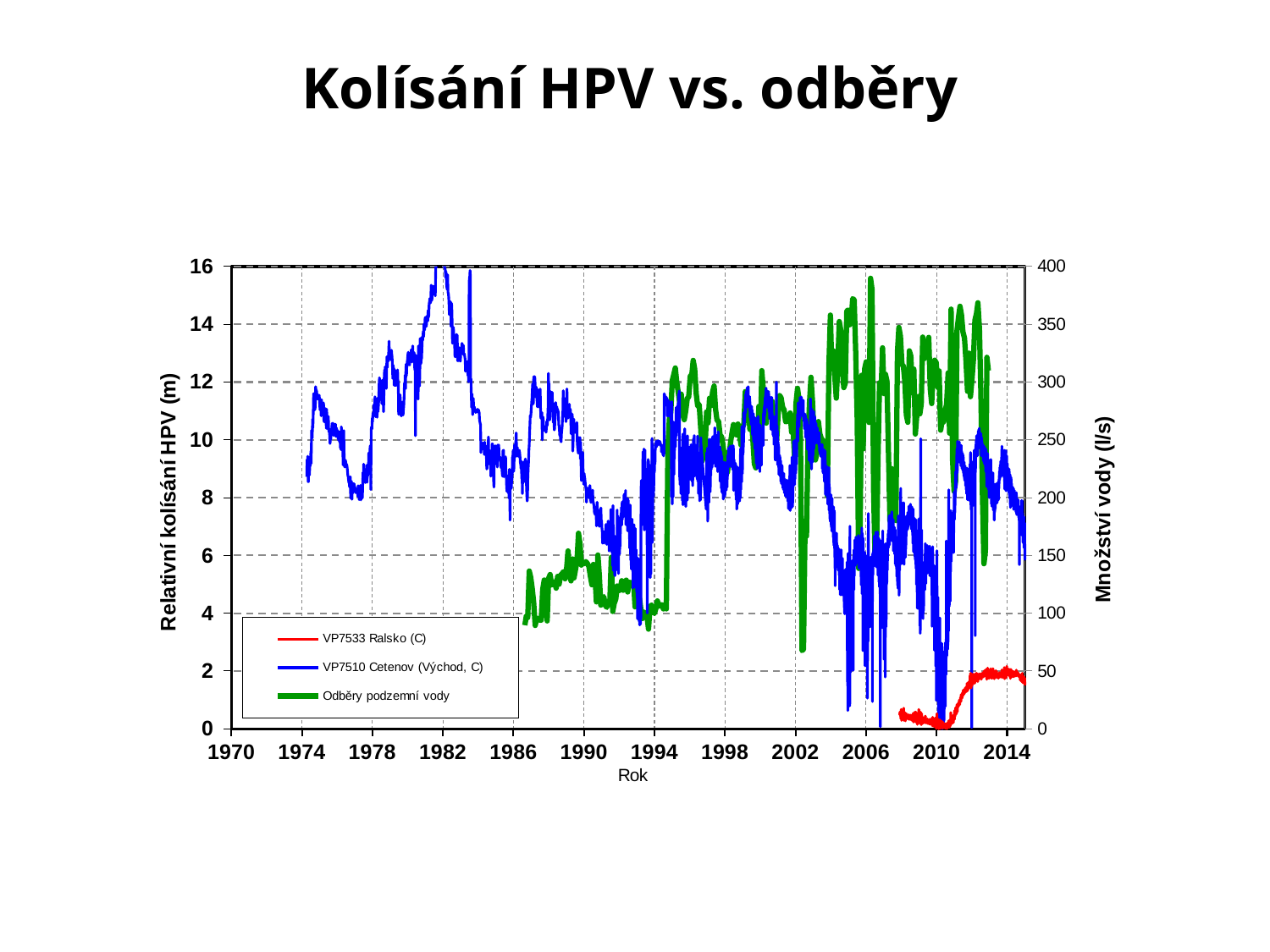
What kind of chart is shown on the slide? line chart Is the peak value of VP7510 Cetenov (Východ, C) around 1982 greater or less than 14 m? greater Is the highest value reached by Odběry podzemní vody greater or less than 350 l/s? greater Which series is drawn in green? Odběry podzemní vody Is the value of Odběry podzemní vody around 1988 greater or less than 200 l/s? less Does the VP7533 Ralsko (C) series rise or fall between 2010 and 2012? rise What is the label of the x axis? Rok Which series begins earliest on the x axis? VP7510 Cetenov (Východ, C) How many series does the legend list? 3 Does the Odběry podzemní vody series generally rise or fall between 1987 and 2012? rise